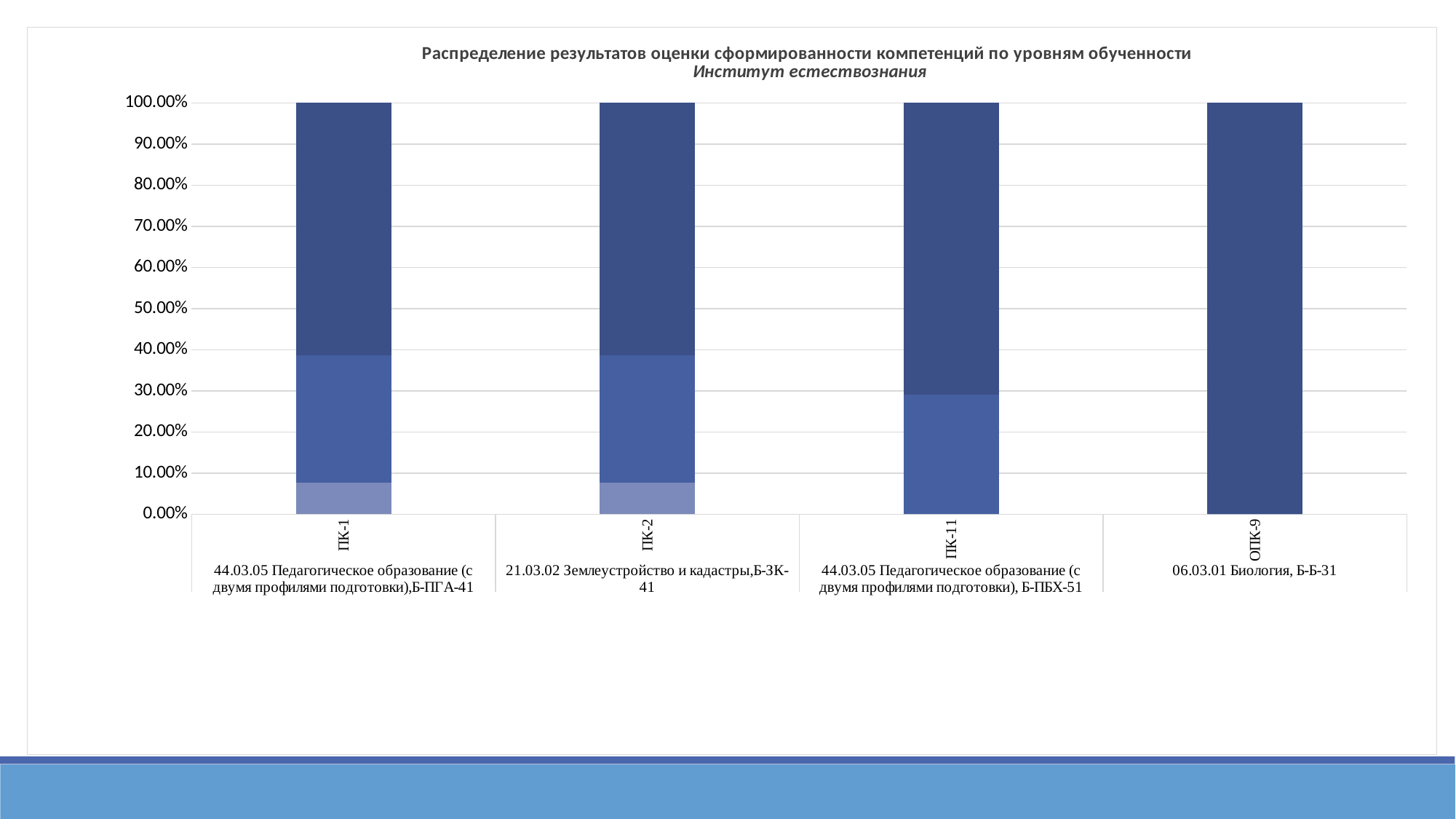
Is the lightest (bottom) segment of the ПК-1 bar greater or less than 10%? less Which competency is associated with the programme 06.03.01 Биология, Б-Б-31? ОПК-9 What kind of chart is shown on the slide? Stacked bar chart Is the top boundary of the medium-blue segment in the ПК-11 bar greater or less than 40%? less What is the total height of the stacked bar for ПК-1? 100.00% How many competency categories are shown along the x axis? 4 Is the top boundary of the medium-blue segment in the ПК-2 bar greater or less than 30%? greater How many coloured segments make up the bar for ОПК-9? 1 What is the total height of the stacked bar for ОПК-9? 100.00% How many coloured segments make up the bar for ПК-11? 2 Which institute is named in the chart subtitle? Институт естествознания